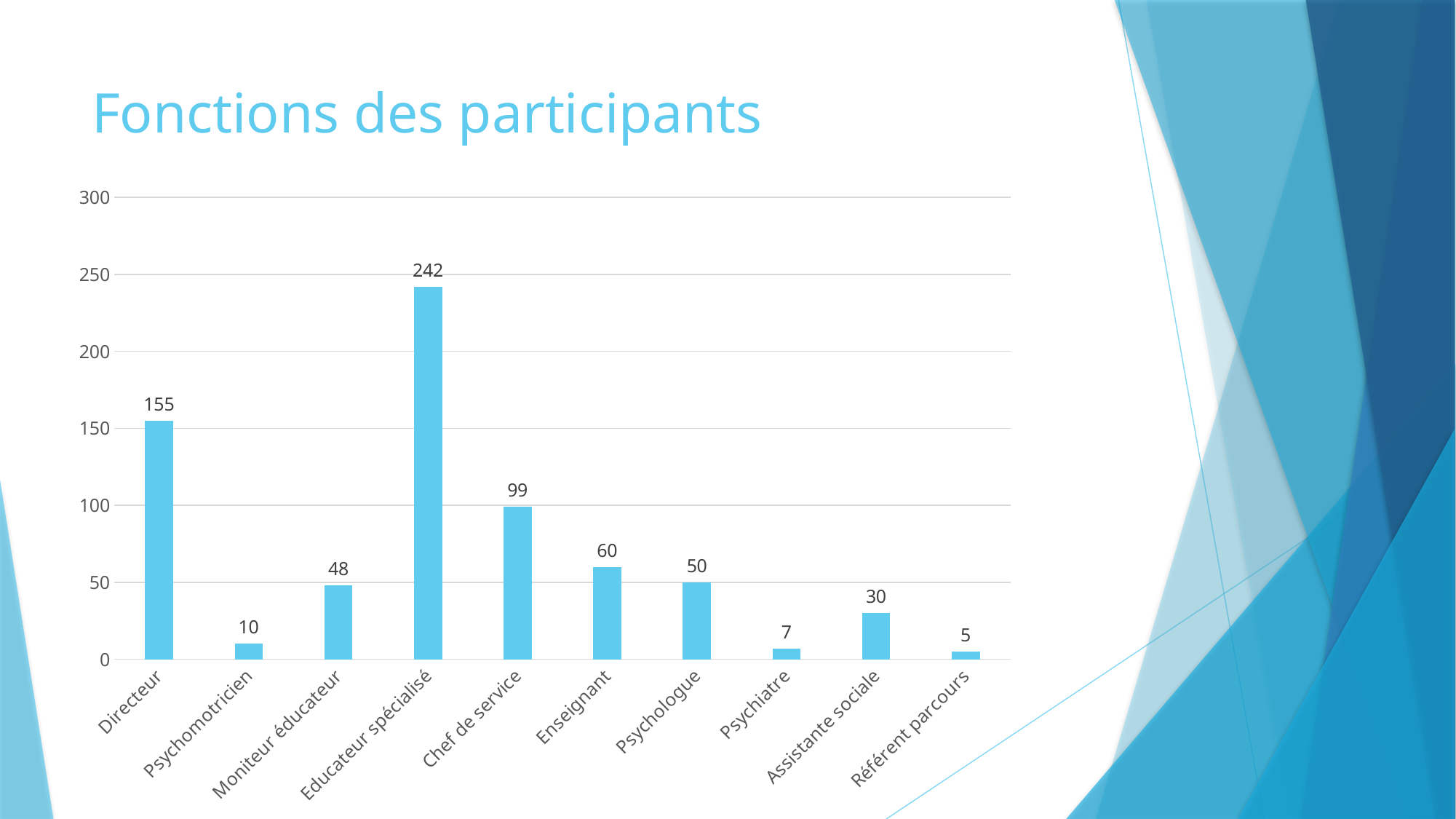
Which is larger, the value for Moniteur éducateur or the value for Psychomotricien? Moniteur éducateur What is the value for Assistante sociale? 30 What is the value for Educateur spécialisé? 242 What kind of chart is shown on the slide? bar chart Which category has the highest value? Educateur spécialisé Is the value for Directeur greater or less than 100? greater What is the difference between the values for Enseignant and Psychologue? 10 What is the title of the slide? Fonctions des participants How many categories are shown on the x axis? 10 What is the difference between the values for Educateur spécialisé and Directeur? 87 What is the value for Chef de service? 99 Which category has the lowest value? Référent parcours